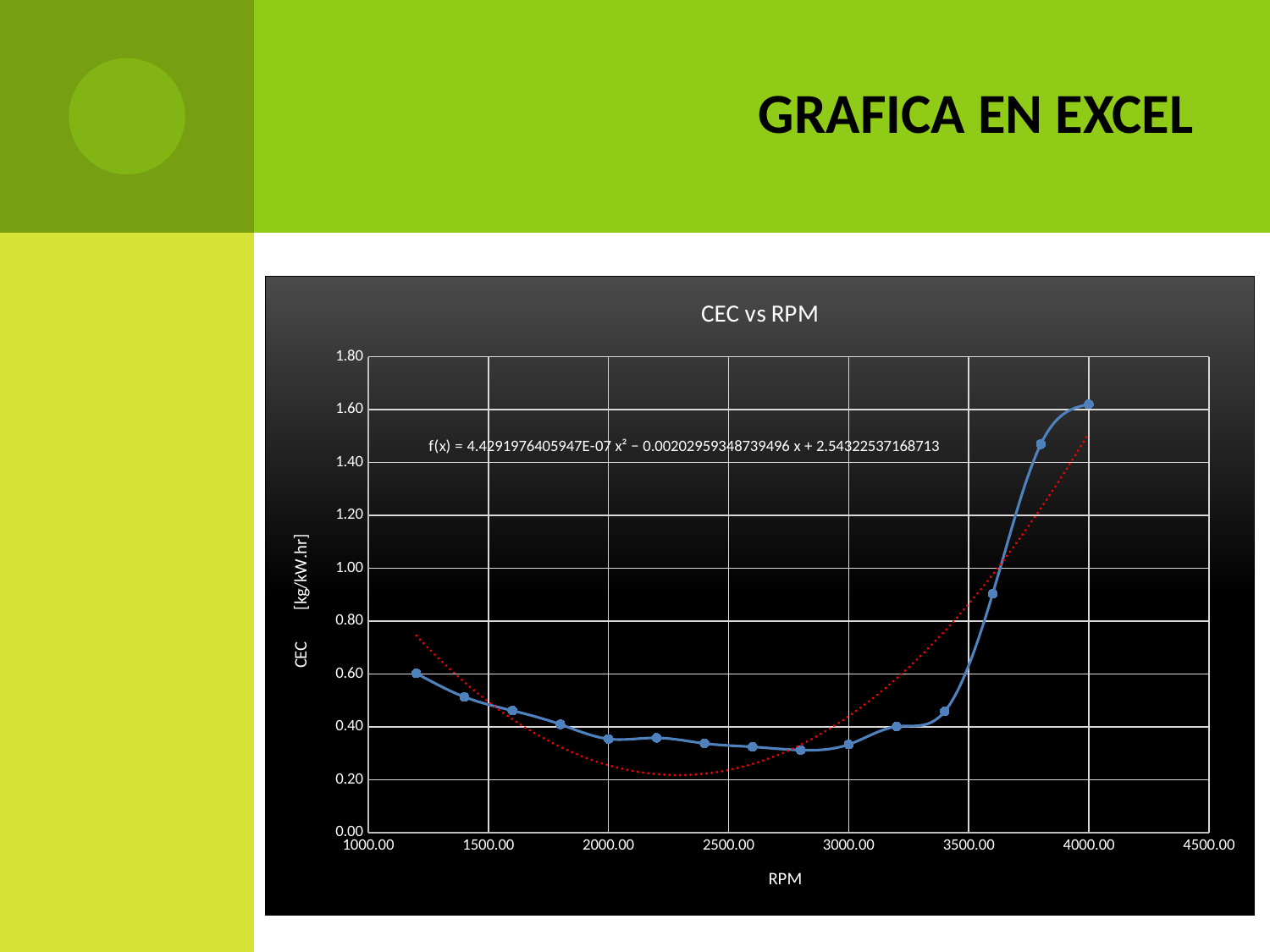
What kind of chart is shown on the slide? Line chart (scatter with smoothed line) At which RPM value is CEC highest? 4000.00 What is the title of the chart? CEC vs RPM Which has a higher CEC value: 1200 RPM or 4000 RPM? 4000 RPM What is the label of the x axis? RPM Is the CEC value at 1200 RPM greater or less than 0.80? less Is the CEC value at 2000 RPM greater or less than 0.40? less Is the CEC value at 3600 RPM greater or less than 1.00? less How does CEC change as RPM increases from 3000 to 4000? It rises How many data points are plotted on the blue line? 15